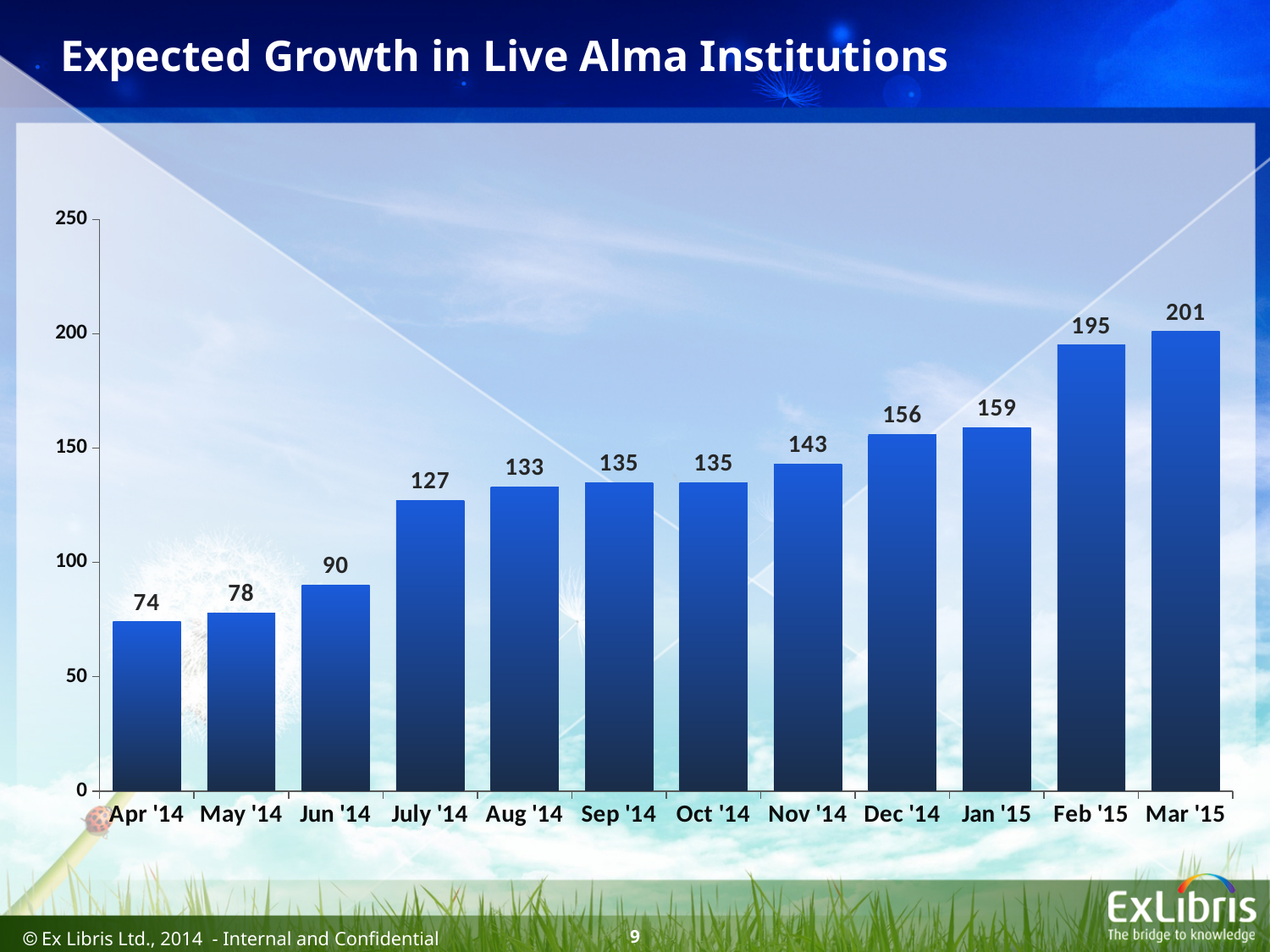
How many months are shown on the x axis? 12 Which month has the highest value? Mar '15 What is the title of the chart? Expected Growth in Live Alma Institutions What is the value for Nov '14? 143 What kind of chart is shown on the slide? Bar chart Which month has the lowest value? Apr '14 Is the value for Aug '14 greater or less than 100? greater What is the value for Jul '14? 127 What is the difference between the values for Feb '15 and Jan '15? 36 Which is larger, the value for Jun '14 or the value for Dec '14? Dec '14 Do the values rise or fall from Apr '14 to Mar '15? Rise What is the difference between the values for Mar '15 and Apr '14? 127